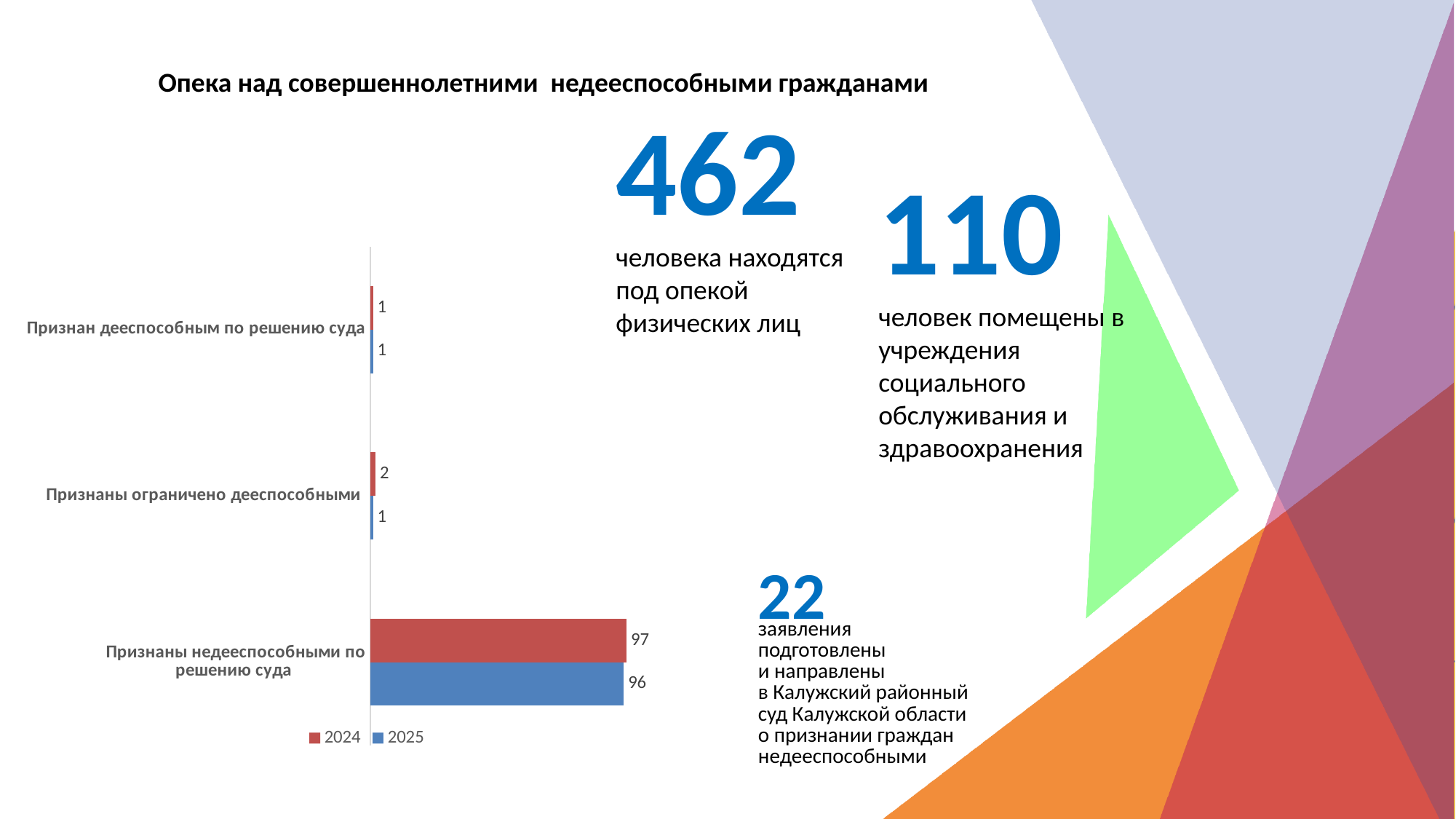
What is the 2024 value for "Признаны недееспособными по решению суда"? 97 What type of chart is shown on the slide? bar chart What is the difference between the 2024 and 2025 values for "Признаны недееспособными по решению суда"? 1 How many series does the chart legend list? 2 How many categories are shown in the chart? 3 What is the 2025 value for "Признаны недееспособными по решению суда"? 96 Which colour represents the 2025 series in the chart? blue For "Признаны ограничено дееспособными", which year has the larger value, 2024 or 2025? 2024 Which category has the highest value for 2024? Признаны недееспособными по решению суда What is the 2025 value for "Признан дееспособным по решению суда"? 1 What is the 2024 value for "Признаны ограничено дееспособными"? 2 What is the difference between the 2024 and 2025 values for "Признаны ограничено дееспособными"? 1